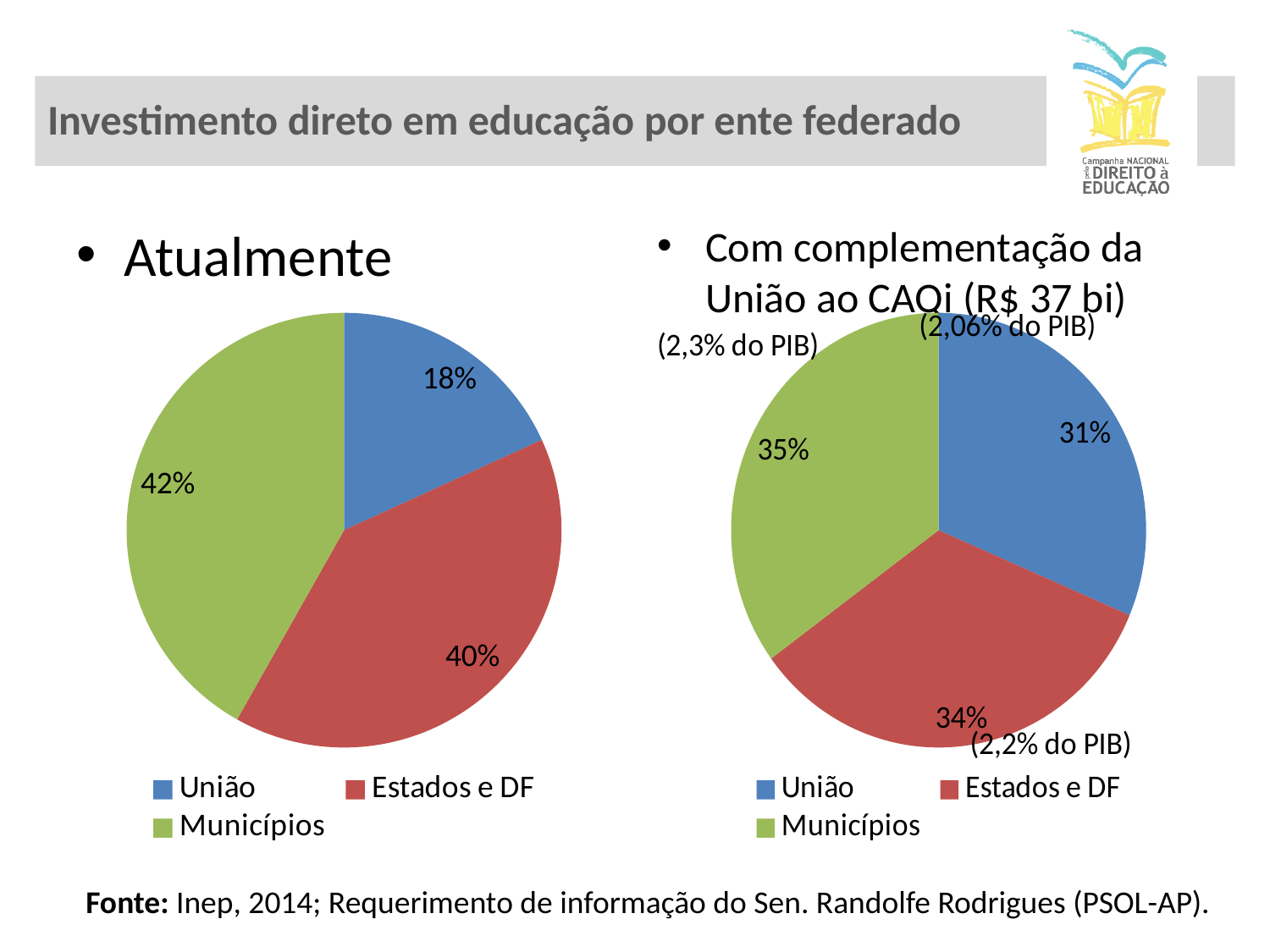
In the right pie chart (Com complementação da União ao CAQi), which entity has the smallest share? União What is the difference between União's share in the right pie chart and its share in the left pie chart? 13 percentage points In the left pie chart (Atualmente), what share do Municípios have? 42% In the right pie chart (Com complementação da União ao CAQi), what share does União have? 31% In the right pie chart (Com complementação da União ao CAQi), what share do Estados e DF have? 34% How many slices does the left pie chart (Atualmente) have? 3 In the left pie chart (Atualmente), which entity has the smallest share? União What type of chart is used on this slide? Pie chart In the left pie chart (Atualmente), what share do Estados e DF have? 40% In the left pie chart (Atualmente), what share does União have? 18% In the right pie chart (Com complementação da União ao CAQi), what share do Municípios have? 35% In the left pie chart (Atualmente), which entity has the largest share? Municípios